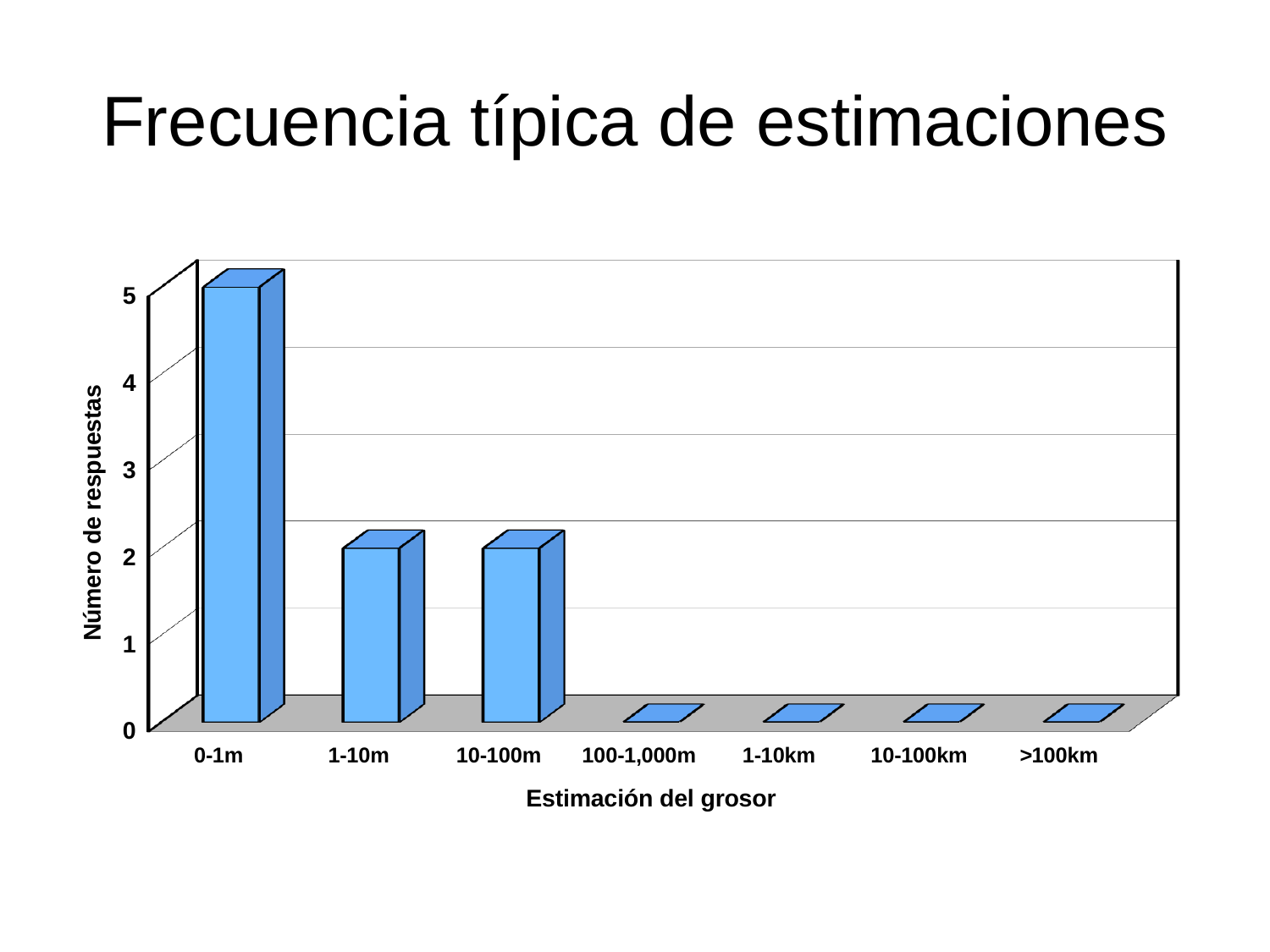
What is the number of responses for the 10-100m category? 2 How many categories are shown on the x axis of the chart? 7 What type of chart is shown on the slide? bar chart What is the number of responses for the 0-1m category? 5 Which category has the highest number of responses? 0-1m What is the number of responses for the >100km category? 0 Which has more responses, 0-1m or 10-100m? 0-1m Is the value for 0-1m greater or less than 4? greater What is the label of the x axis? Estimación del grosor What is the number of responses for the 1-10m category? 2 What is the title of the slide's chart? Frecuencia típica de estimaciones What is the difference in number of responses between 0-1m and 1-10m? 3